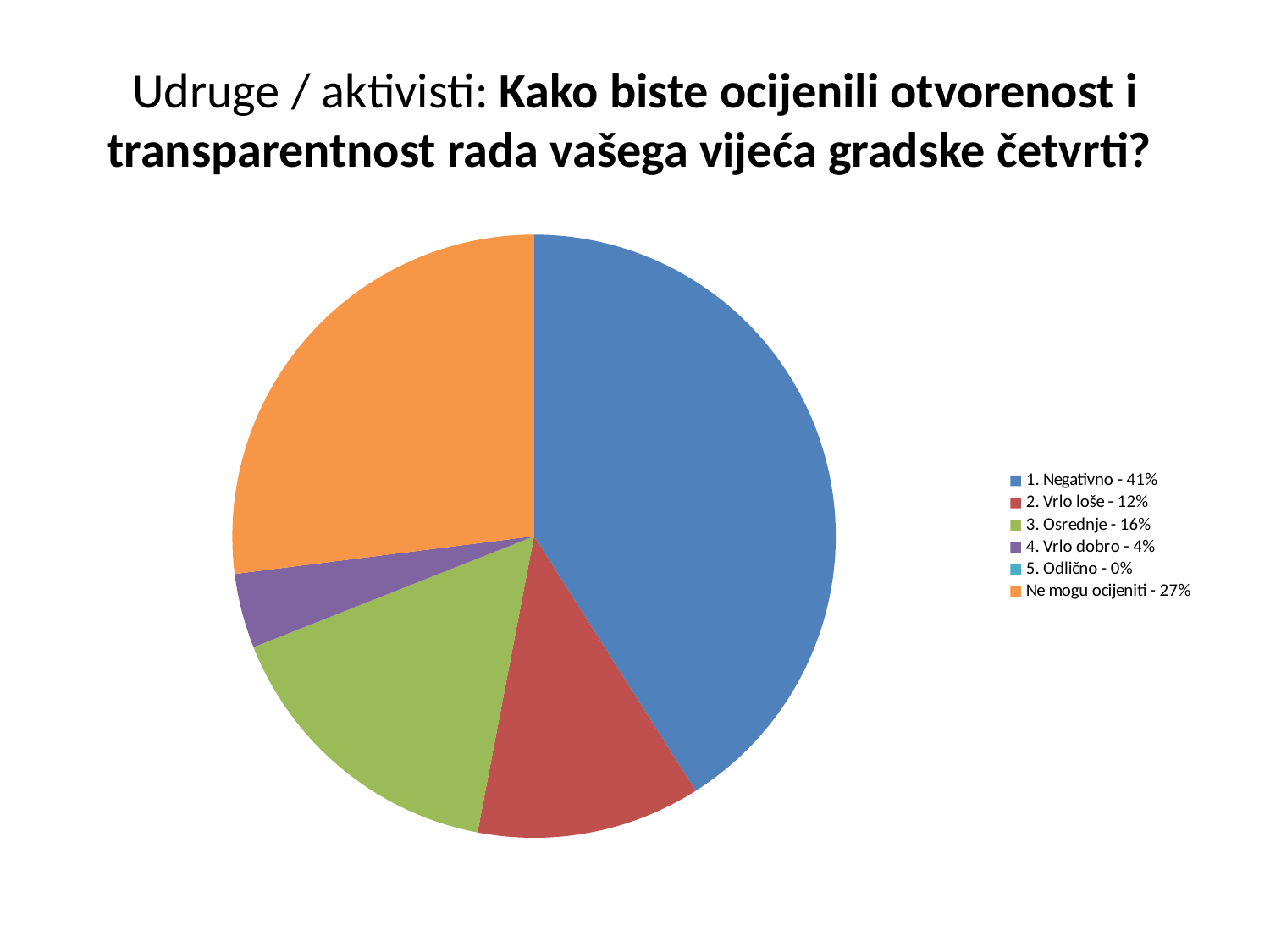
Which category has the largest share of the pie? 1. Negativno How many categories does the legend list? 6 What is the value for "2. Vrlo loše"? 12% Which is larger, the share for "3. Osrednje" or the share for "2. Vrlo loše"? 3. Osrednje What share of the pie does "1. Negativno" represent? 41% Which category has the smallest share of the pie? 5. Odlično What is the value for "3. Osrednje"? 16% What is the difference between the shares of "1. Negativno" and "Ne mogu ocijeniti"? 14% What colour is the slice for "4. Vrlo dobro"? purple What kind of chart is shown on the slide? pie chart What is the value for "5. Odlično"? 0% What share of the pie does "Ne mogu ocijeniti" represent? 27%